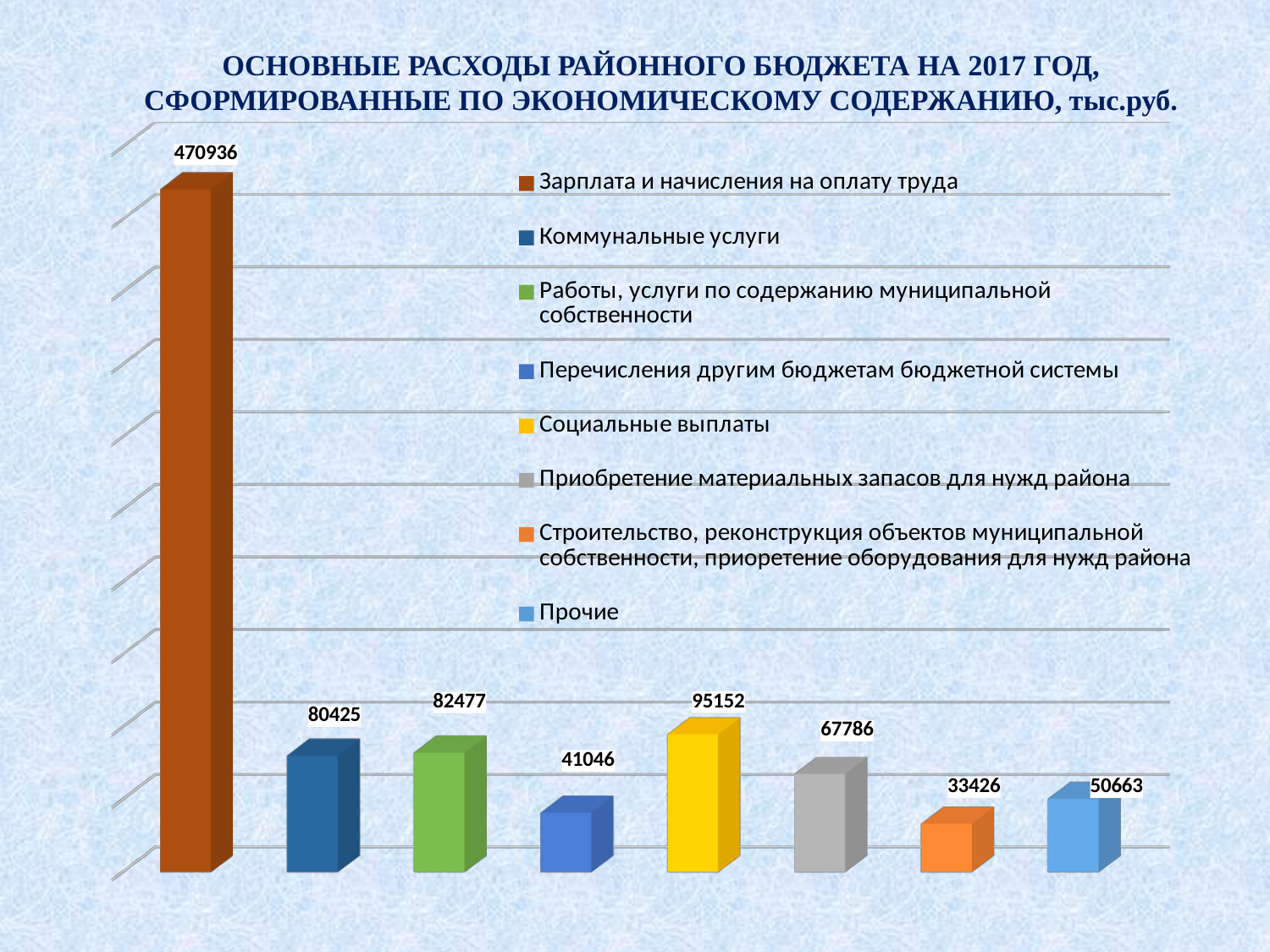
What is the value for Прочие? 50663 Which is larger: the value for Работы, услуги по содержанию муниципальной собственности or the value for Приобретение материальных запасов для нужд района? Работы, услуги по содержанию муниципальной собственности Which category has the lowest value? Строительство, реконструкция объектов муниципальной собственности, приоретение оборудования для нужд района What is the difference between the values for Социальные выплаты and Коммунальные услуги? 14727 How many bars are plotted on the chart? 8 What is the value for Зарплата и начисления на оплату труда? 470936 What is the value for Коммунальные услуги? 80425 How many entries does the legend list? 8 Which category has the highest value? Зарплата и начисления на оплату труда What colour is the bar for Социальные выплаты? Yellow What kind of chart is shown on the slide? Bar chart What is the value for Социальные выплаты? 95152